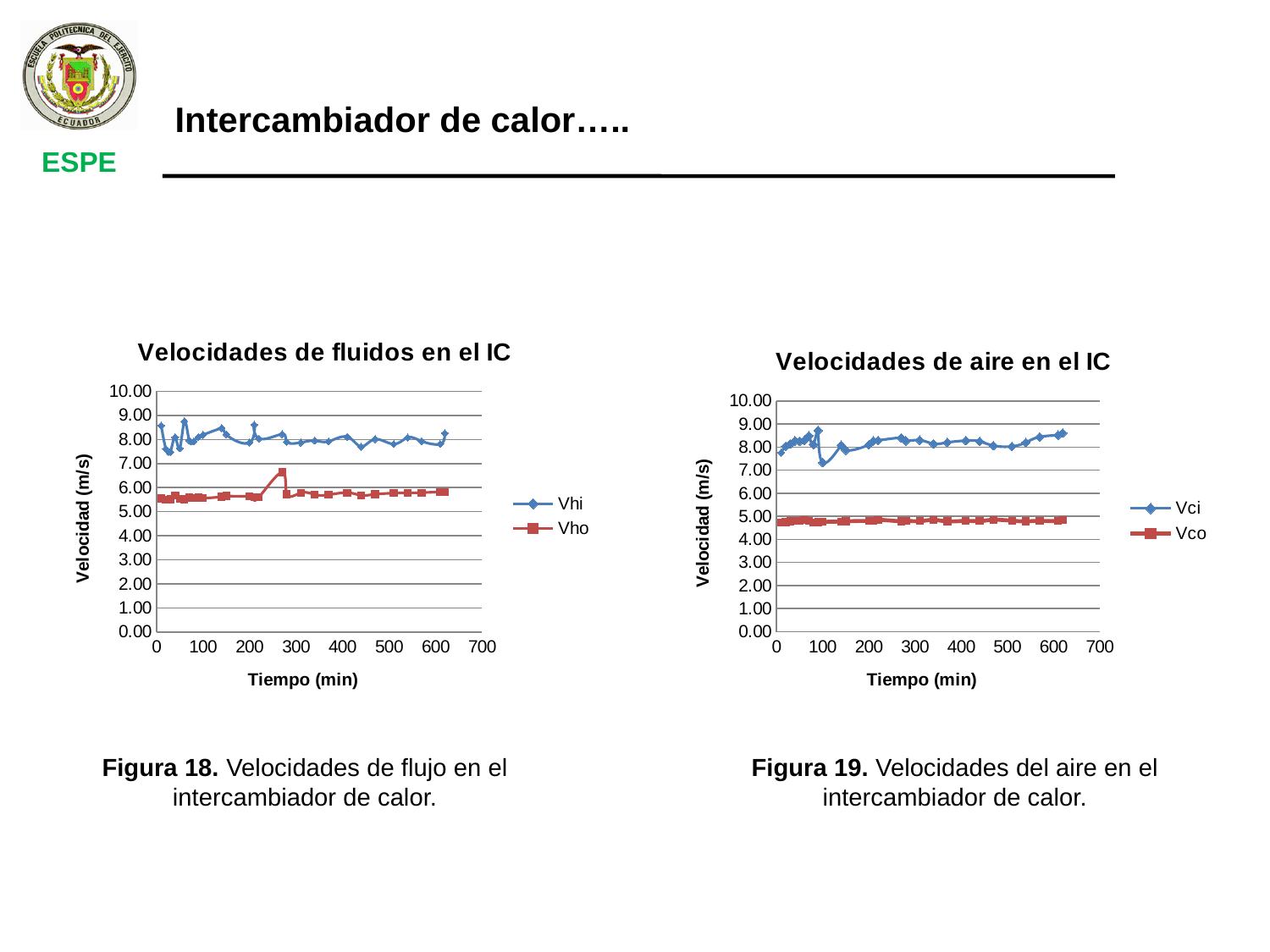
How many series does the legend of "Velocidades de aire en el IC" list? 2 What are the legend entries of "Velocidades de fluidos en el IC"? Vhi, Vho In "Velocidades de aire en el IC", which series has higher values throughout, Vci or Vco? Vci In "Velocidades de fluidos en el IC", is the value of Vho at 600 min greater or less than 7.00? less In "Velocidades de fluidos en el IC", which series has higher values throughout, Vhi or Vho? Vhi How many series does the legend of "Velocidades de fluidos en el IC" list? 2 In "Velocidades de aire en el IC", is the value of Vci at 300 min greater or less than 7.00? greater What kind of chart is "Velocidades de aire en el IC"? line chart In "Velocidades de fluidos en el IC", is the value of Vhi at 600 min greater or less than 7.00? greater What kind of chart is "Velocidades de fluidos en el IC"? line chart What is the x-axis title of "Velocidades de aire en el IC"? Tiempo (min)